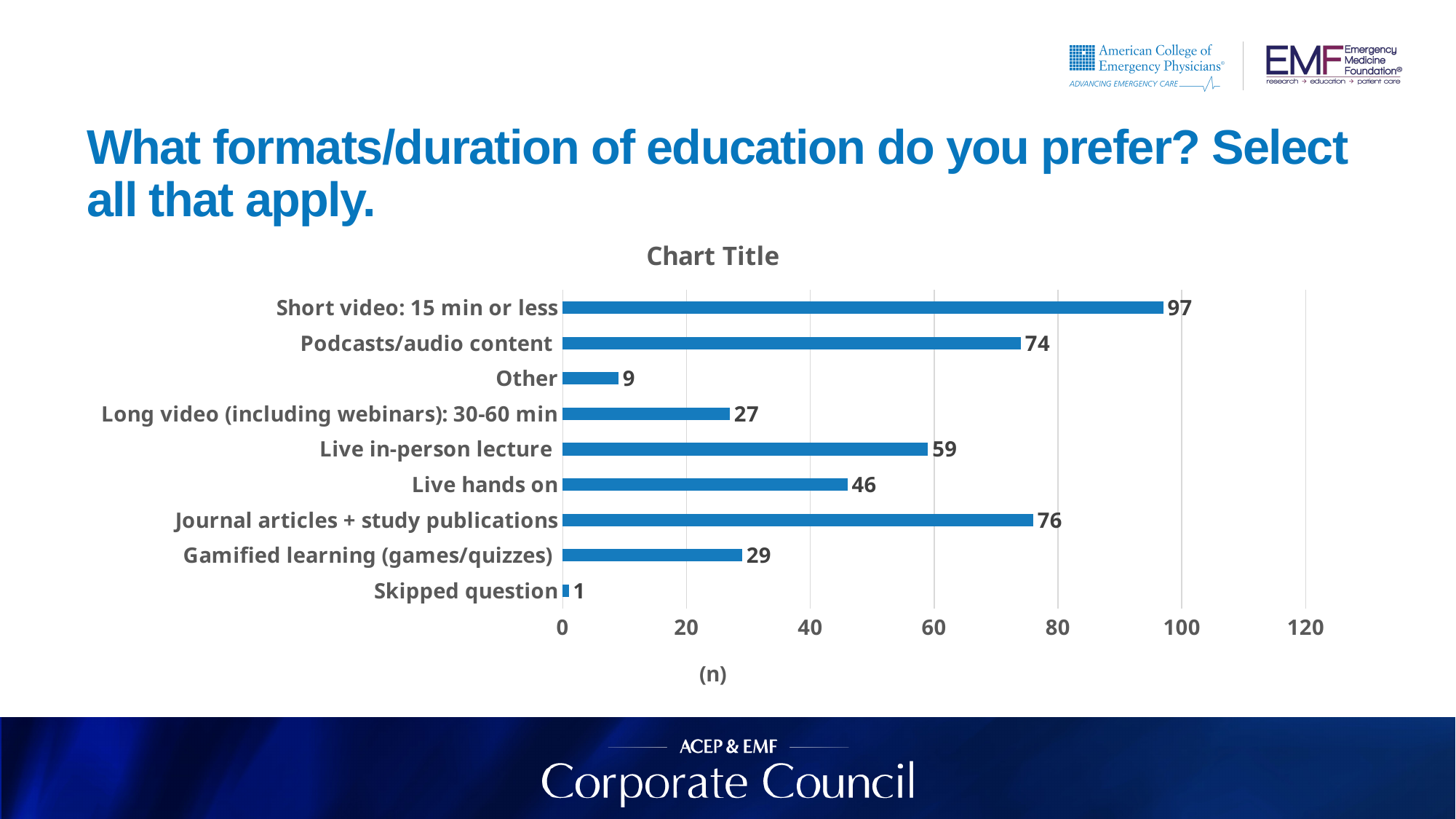
Which category has the lowest value? Skipped question What is the value for Short video: 15 min or less? 97 What is the value for Live hands on? 46 What kind of chart is shown on the slide? Bar chart What is the value for Gamified learning (games/quizzes)? 29 How many categories are shown in the chart? 9 What is the label on the horizontal axis of the chart? (n) What is the difference between the values for Journal articles + study publications and Podcasts/audio content? 2 What is the value for Podcasts/audio content? 74 Which is larger, the value for Live in-person lecture or the value for Live hands on? Live in-person lecture Which category has the highest value? Short video: 15 min or less What is the difference between the values for Live in-person lecture and Long video (including webinars): 30-60 min? 32